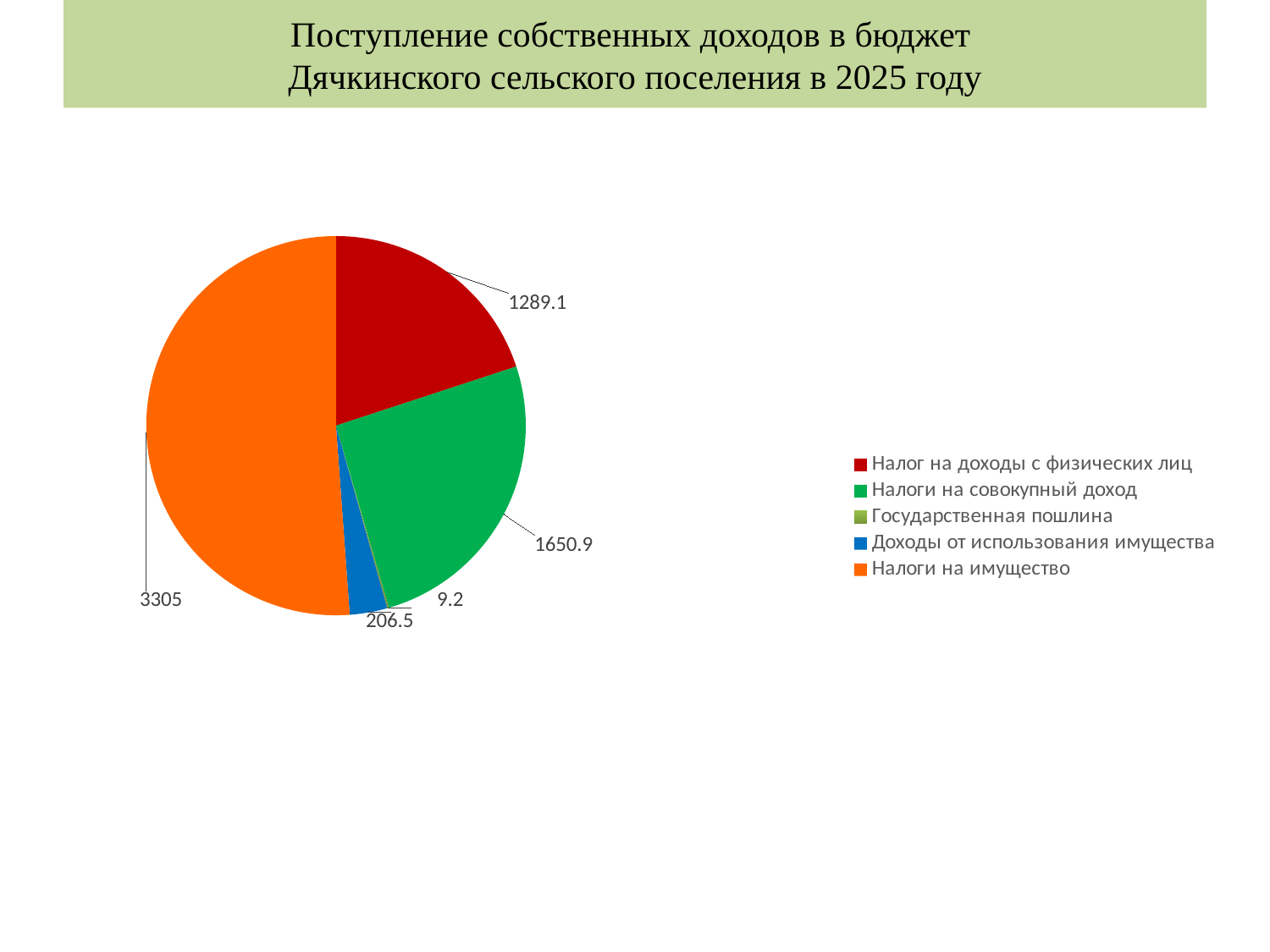
Which is larger, Налоги на совокупный доход or Налог на доходы с физических лиц? Налоги на совокупный доход What colour is the slice for Доходы от использования имущества? Blue What is the value for Государственная пошлина? 9.2 What is the value for Доходы от использования имущества? 206.5 What is the value for Налоги на имущество? 3305 Which category has the largest slice of the pie? Налоги на имущество How many categories does the legend list? 5 What is the value for Налоги на совокупный доход? 1650.9 Which category has the smallest slice of the pie? Государственная пошлина What is the value for Налог на доходы с физических лиц? 1289.1 What is the difference between Налоги на имущество and Налоги на совокупный доход? 1654.1 What type of chart is shown on the slide? Pie chart